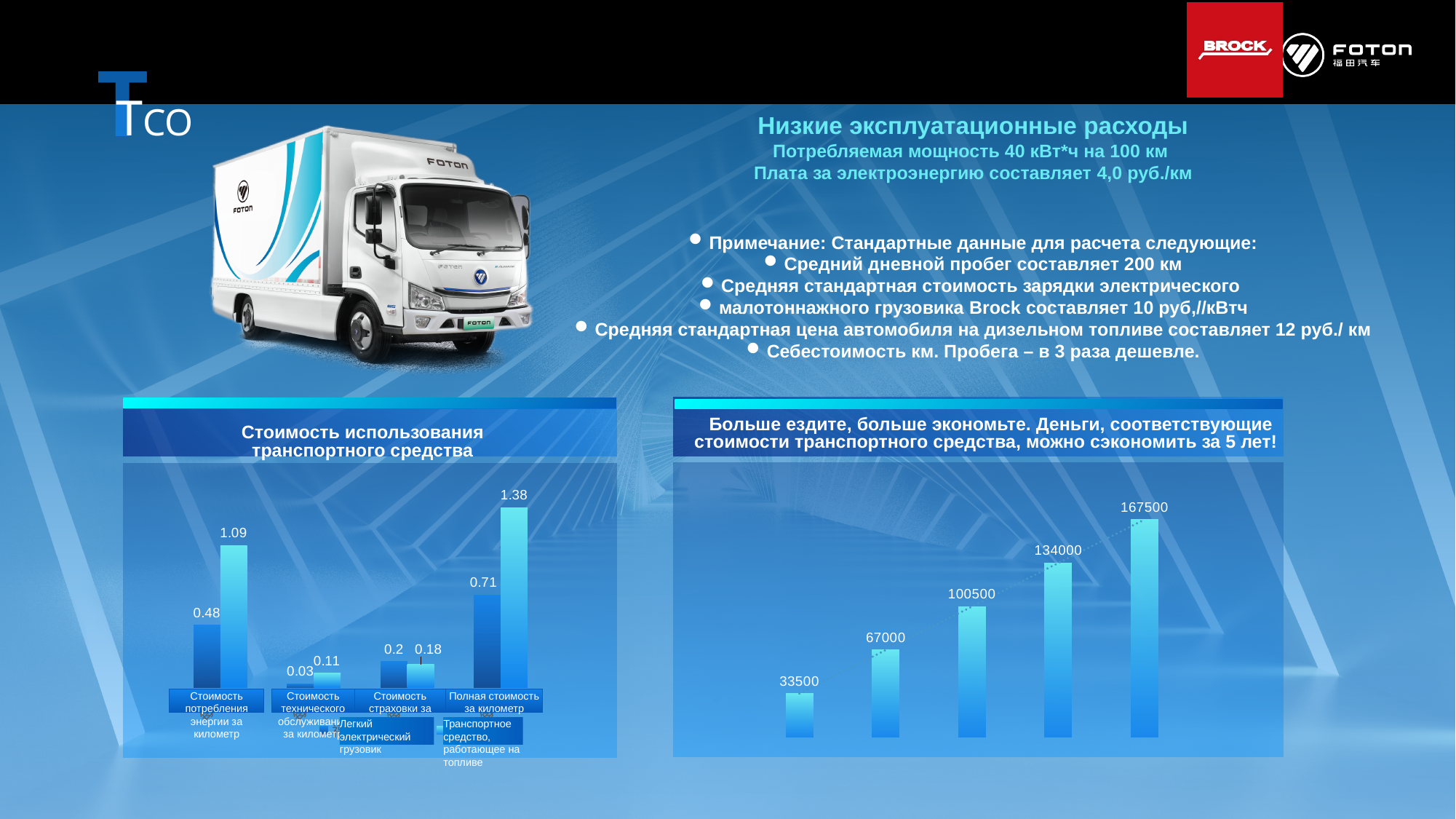
On the chart titled 'Стоимость использования транспортного средства', how many series does the legend list? 2 On the chart titled 'Стоимость использования транспортного средства', what is the value for the light electric truck (Легкий электрический грузовик) for 'Стоимость потребления энергии за километр'? 0.48 On the chart titled 'Стоимость использования транспортного средства', what is the difference between the fuel-powered vehicle and the light electric truck for 'Полная стоимость за километр'? 0.67 On the chart titled 'Стоимость использования транспортного средства', what is the value for the fuel-powered vehicle (Транспортное средство, работающее на топливе) for 'Полная стоимость за километр'? 1.38 On the chart titled 'Стоимость использования транспортного средства', how many categories are shown on the x axis? 4 On the chart titled 'Стоимость использования транспортного средства', what is the value for the light electric truck for 'Стоимость технического обслуживания за километр'? 0.03 On the right-hand chart ('Больше ездите, больше экономьте...'), how many bars are plotted? 5 On the chart titled 'Стоимость использования транспортного средства', which is larger for 'Стоимость страховки за километр': the light electric truck or the fuel-powered vehicle? Легкий электрический грузовик On the right-hand chart ('Больше ездите, больше экономьте...'), what is the value of the lowest bar? 33500 On the right-hand chart ('Больше ездите, больше экономьте...'), do the values rise or fall from left to right? Rise What kind of chart is the chart titled 'Стоимость использования транспортного средства'? Bar chart On the right-hand chart ('Больше ездите, больше экономьте...'), what is the value of the highest bar? 167500